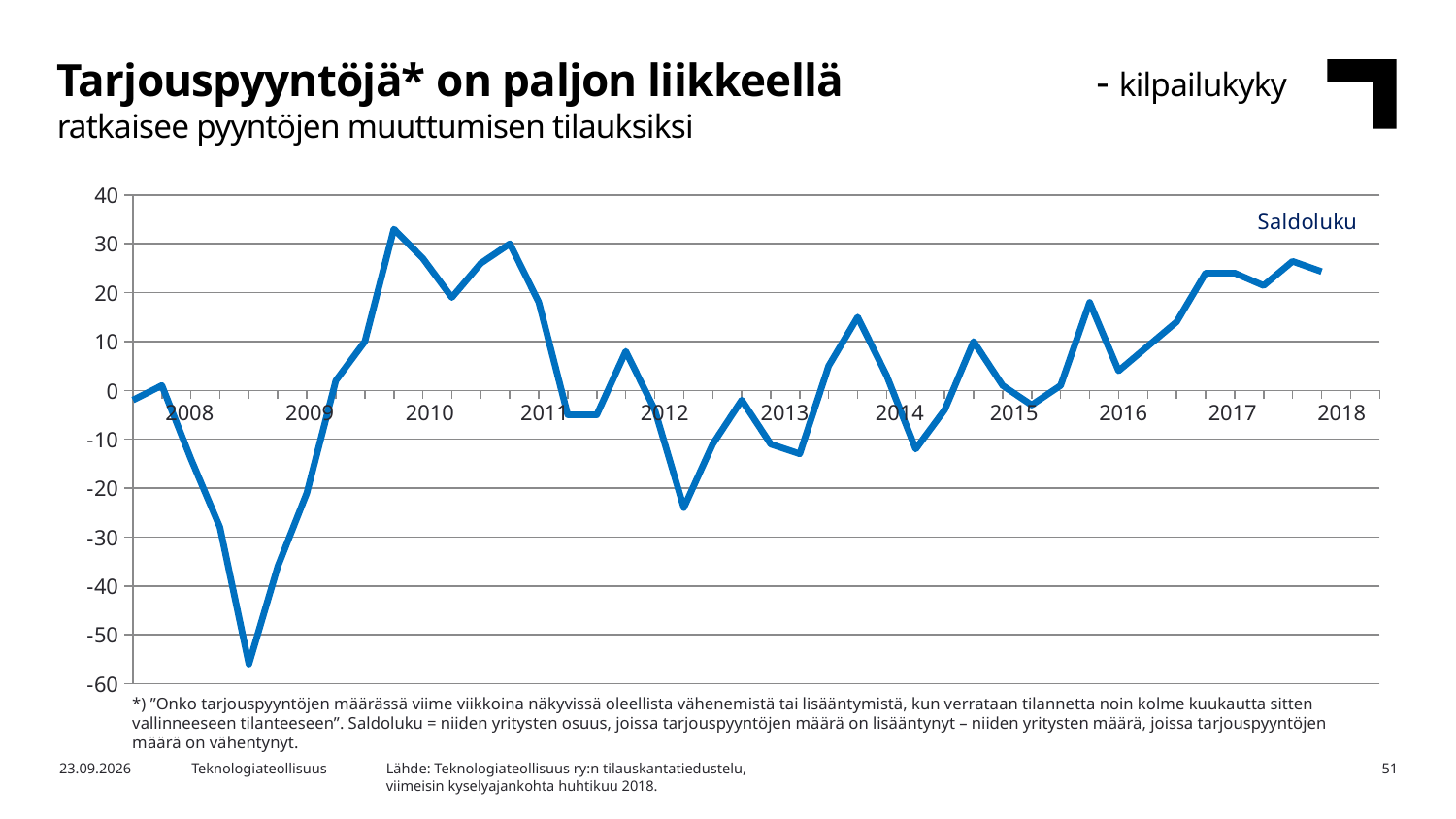
Is the value at the 2012 tick greater or less than 0? less How many year labels are shown on the x axis? 11 What is the lowest value shown on the y axis? -60 What is the name of the series plotted on the chart? Saldoluku Is the value at the 2018 tick greater or less than 20? greater How many data series does the chart show? 1 Does the line generally rise or fall from the 2015 tick to the 2018 tick? rise What kind of chart is shown on the slide? line chart Does the line rise or fall between the 2008 tick and the lowest point before 2009? fall Is the value at the 2017 tick greater or less than 10? greater